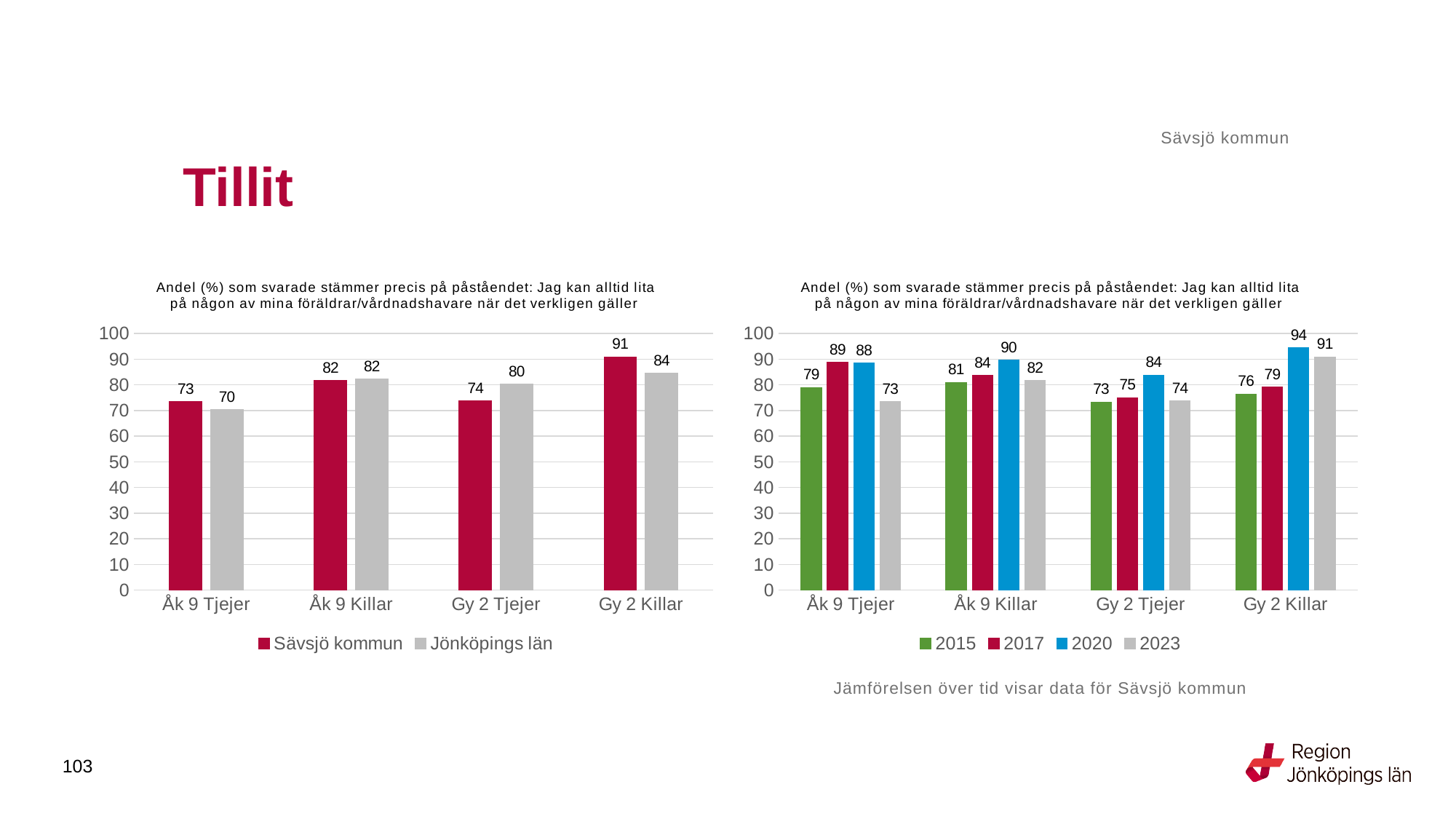
In the right chart, which category has the lowest value for 2023? Åk 9 Tjejer In the left chart, which is larger for Gy 2 Tjejer: Sävsjö kommun or Jönköpings län? Jönköpings län In the left chart, how many series does the legend list? 2 In the right chart, what is the difference between 2020 and 2023 for Åk 9 Tjejer? 15 In the right chart, what is the value for 2020 for Gy 2 Killar? 94 In the left chart, which category has the highest value for Sävsjö kommun? Gy 2 Killar In the right chart, what is the value for 2015 for Åk 9 Tjejer? 79 In the left chart, what is the difference between Sävsjö kommun and Jönköpings län for Gy 2 Killar? 7 In the left chart, what is the value for Sävsjö kommun for Gy 2 Killar? 91 In the right chart, how many series does the legend list? 4 What kind of chart is the right chart? Bar chart In the left chart, what is the value for Jönköpings län for Åk 9 Tjejer? 70